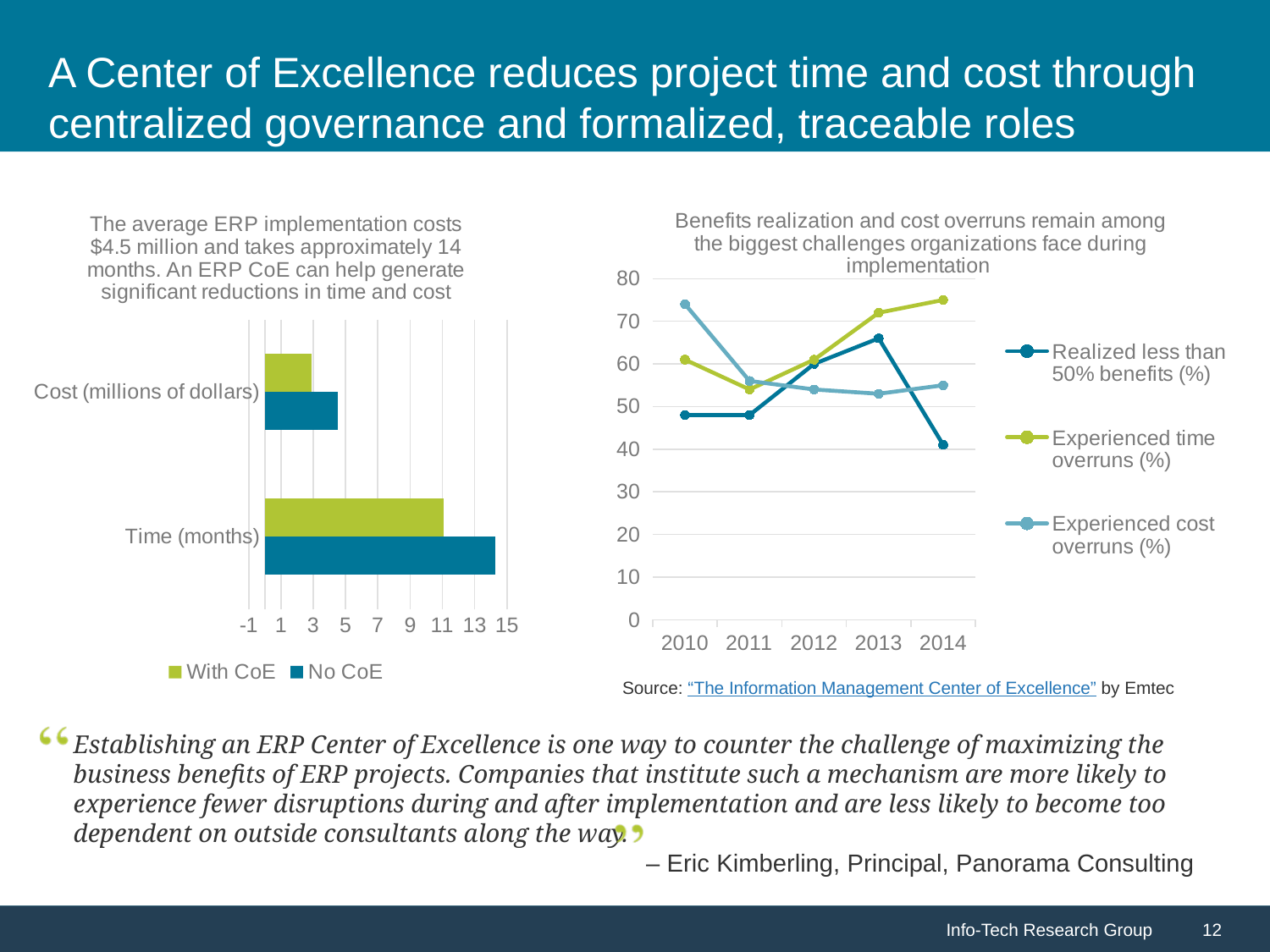
In the left bar chart, is the No CoE value for Time (months) greater or less than 13? greater In the left bar chart, how many series does the legend list? 2 In the right line chart, how many series does the legend list? 3 In the left bar chart, which series has the larger value for Time (months), With CoE or No CoE? No CoE What kind of chart is the left chart titled "The average ERP implementation costs $4.5 million..."? bar chart In the right line chart, which series is shown in the darkest blue line? Realized less than 50% benefits (%) In the right line chart, is the Experienced cost overruns (%) value for 2010 greater or less than 70? greater In the right line chart, which year has the lowest value for Realized less than 50% benefits (%)? 2014 In the right line chart, how many years are shown on the x axis? 5 In the right line chart, which year has the highest value for Experienced time overruns (%)? 2014 In the left bar chart, is the With CoE value for Cost (millions of dollars) greater or less than 5? less What kind of chart is the right chart titled "Benefits realization and cost overruns remain among the biggest challenges..."? line chart